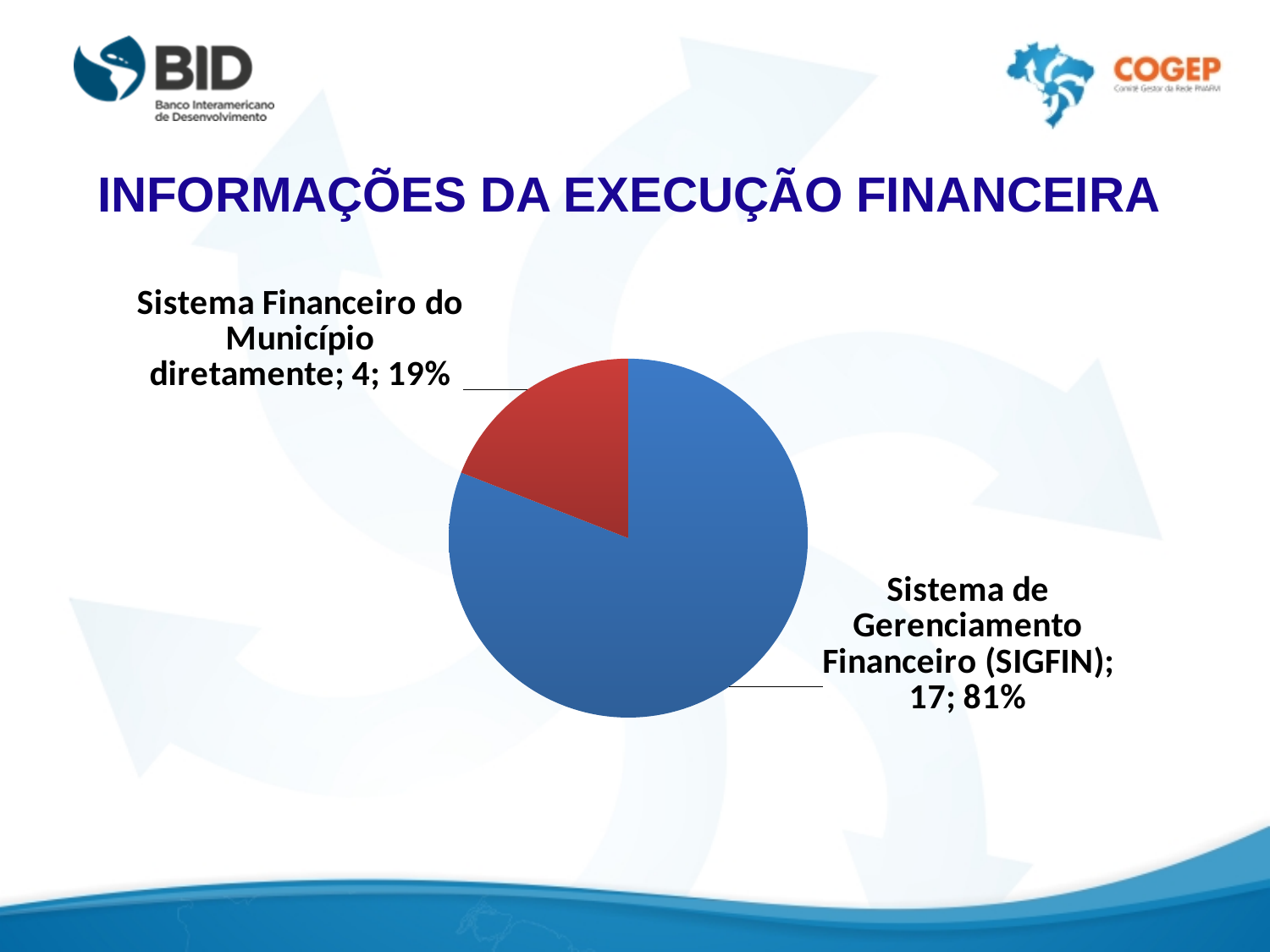
Which is larger: the value for Sistema de Gerenciamento Financeiro (SIGFIN) or for Sistema Financeiro do Município diretamente? Sistema de Gerenciamento Financeiro (SIGFIN) What is the difference between the values for Sistema de Gerenciamento Financeiro (SIGFIN) and Sistema Financeiro do Município diretamente? 13 What kind of chart is shown on the slide? pie chart What colour is the slice for Sistema Financeiro do Município diretamente? red How many slices does the pie chart have? 2 What is the total of the two values shown in the pie chart? 21 Which category has the largest slice? Sistema de Gerenciamento Financeiro (SIGFIN) What is the value for Sistema Financeiro do Município diretamente? 4 What is the value for Sistema de Gerenciamento Financeiro (SIGFIN)? 17 What share of the pie does Sistema de Gerenciamento Financeiro (SIGFIN) represent? 81% Which category has the smallest slice? Sistema Financeiro do Município diretamente What share of the pie does Sistema Financeiro do Município diretamente represent? 19%